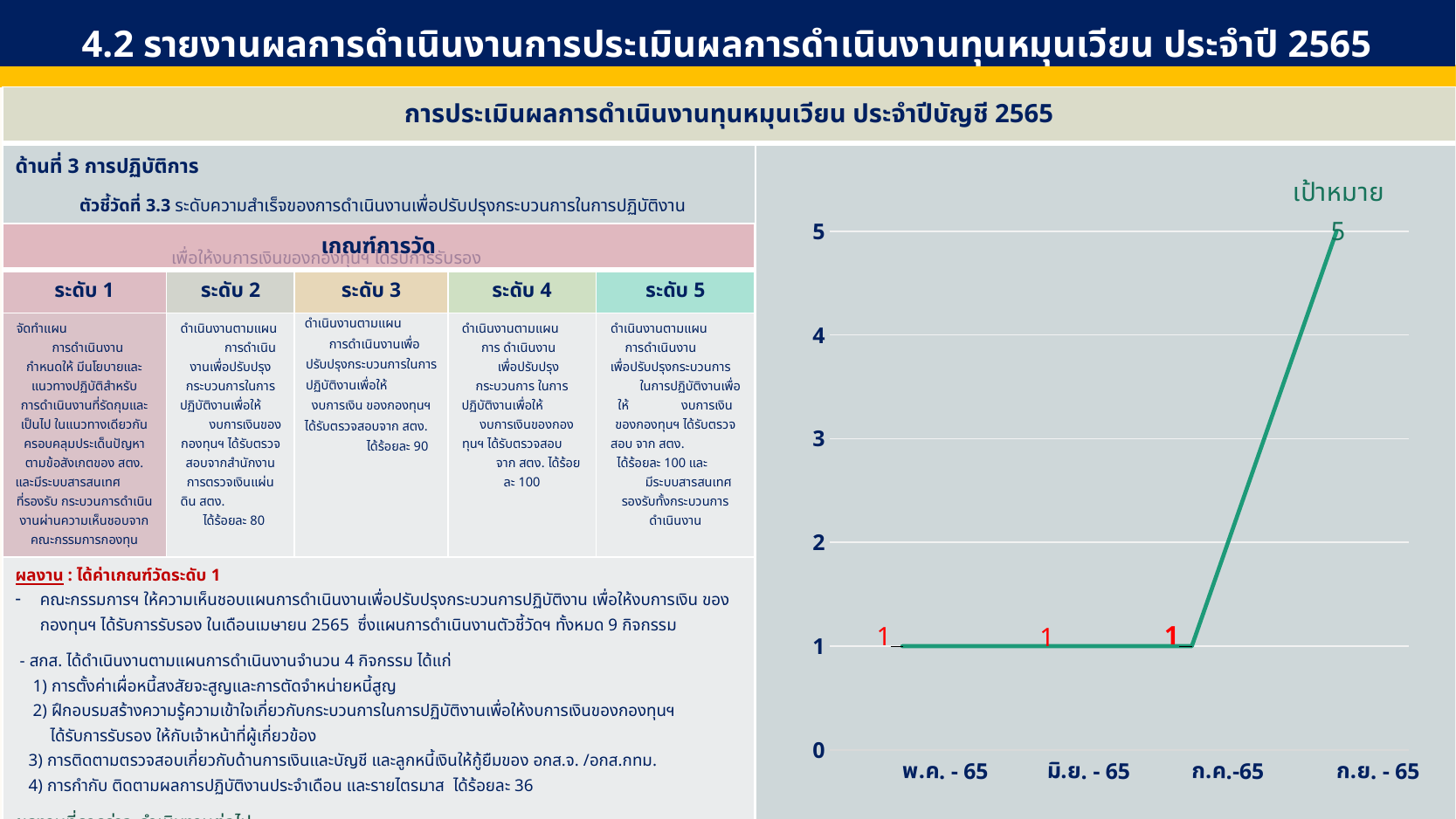
Is the value for ก.ย. - 65 greater or less than 4? greater What is the value plotted for พ.ค. - 65? 1 Which x-axis category has the highest value on the chart? ก.ย. - 65 What kind of chart is shown on the right side of the slide? line chart Which is larger, the value for ก.ย. - 65 or the value for พ.ค. - 65? ก.ย. - 65 What is the value plotted for มิ.ย. - 65? 1 What label appears in green at the top right of the chart? เป้าหมาย What is the difference between the value for ก.ย. - 65 and the value for ก.ค.-65? 4 Do the plotted values rise or fall from left to right along the x axis? rise What is the value plotted for ก.ย. - 65? 5 How many x-axis categories are plotted on the chart? 4 What is the value plotted for ก.ค.-65? 1